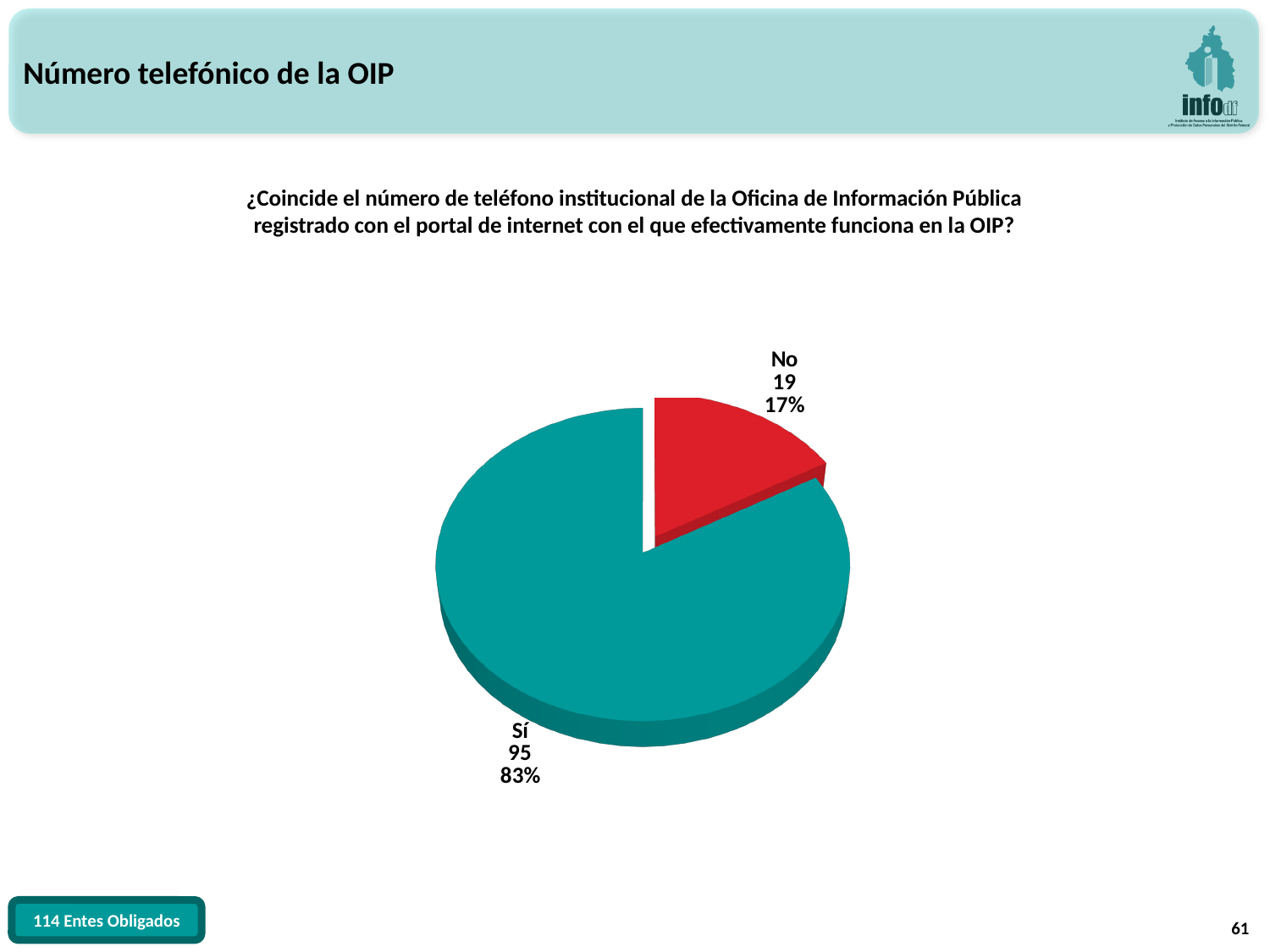
What percentage share does the "Sí" slice represent? 83% What is the count for the "Sí" slice? 95 What is the difference between the counts for "Sí" and "No"? 76 What is the total of the two slice counts? 114 Which slice is the largest? Sí Which slice is the smallest? No Which is larger, the "Sí" slice or the "No" slice? Sí What kind of chart is shown on the slide? pie chart What colour is the "No" slice? red How many slices does the pie chart have? 2 What percentage share does the "No" slice represent? 17% What is the count for the "No" slice? 19